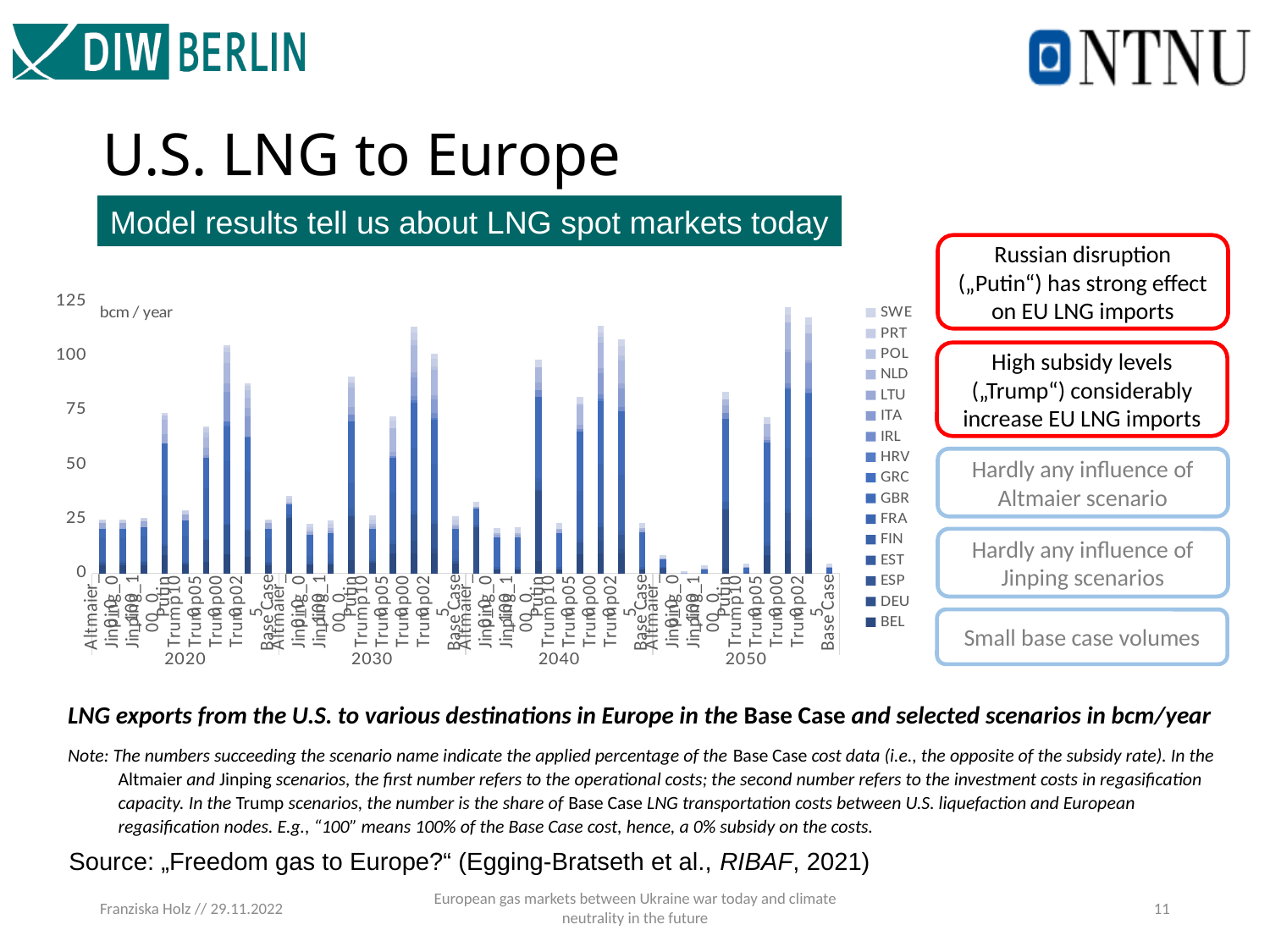
How many year groups are shown along the x axis of the chart? 4 Is the total value for Altmaier in the 2020 group greater or less than 50? less Is the total value for Putin in the 2030 group greater or less than 75? greater Is the total value for Trump02 in the 2020 group greater or less than 75? greater How many series does the chart legend list? 16 Which series is listed first (at the top) in the chart legend? SWE Within the 2020 group, which is larger: the total for Trump00 or the total for Trump05? Trump00 What unit is shown on the chart's y axis? bcm / year What kind of chart is shown on the slide? stacked bar chart